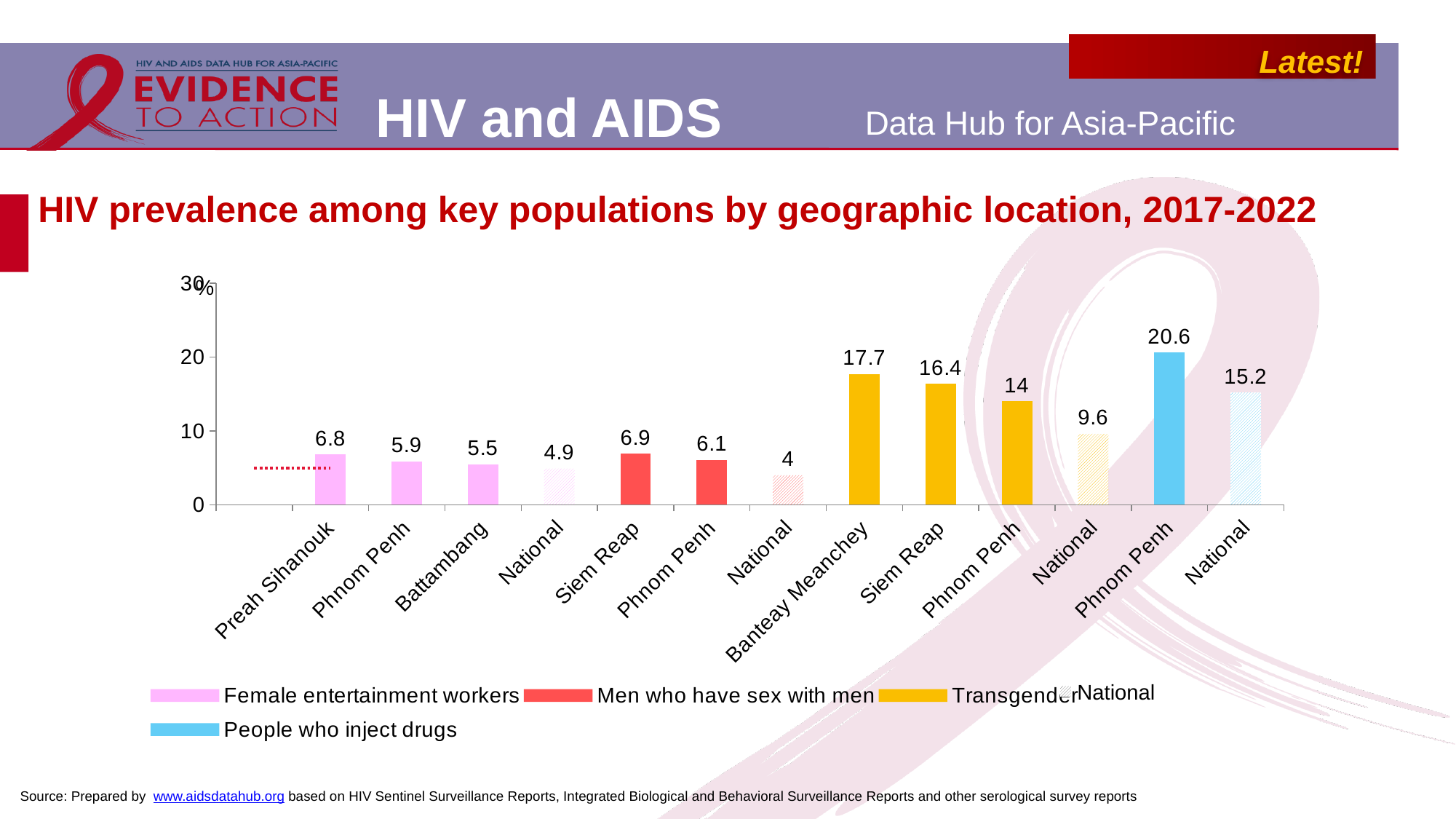
How many bars are plotted on the chart? 13 What is the HIV prevalence among female entertainment workers in Preah Sihanouk? 6.8 What is the difference between the transgender HIV prevalence in Banteay Meanchey and in Siem Reap? 1.3 Is the national HIV prevalence among people who inject drugs greater or less than 10? greater What is the national HIV prevalence among men who have sex with men? 4 How many entries does the legend list? 5 What kind of chart is shown on the slide? Bar chart Which bar has the lowest value on the chart? National (Men who have sex with men), 4 Which bar has the highest value on the chart? Phnom Penh (People who inject drugs), 20.6 Which is larger: the HIV prevalence among female entertainment workers in Phnom Penh or among men who have sex with men in Phnom Penh? Men who have sex with men in Phnom Penh (6.1) What is the HIV prevalence among transgender people in Banteay Meanchey? 17.7 What is the HIV prevalence among people who inject drugs in Phnom Penh? 20.6